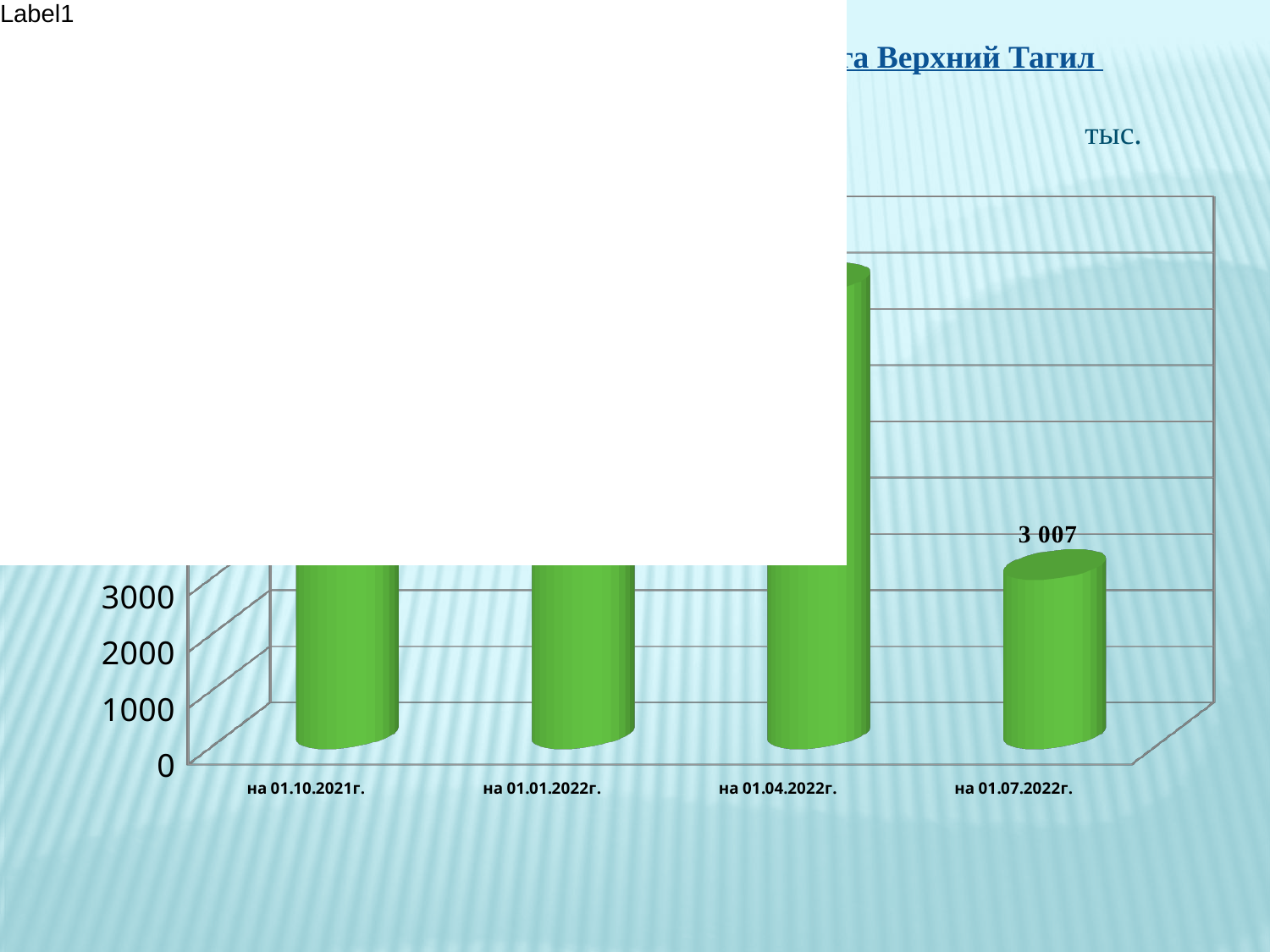
Which is larger, the value for на 01.04.2022г. or the value for на 01.07.2022г.? на 01.04.2022г. What is the label of the first category on the x axis? на 01.10.2021г. What kind of chart is shown on the slide? bar chart How many categories are shown on the x axis? 4 What is the value for на 01.07.2022г.? 3 007 What is the label of the last category on the x axis? на 01.07.2022г. Is the value for на 01.04.2022г. greater or less than 3000? greater Is the value for на 01.07.2022г. greater or less than 2000? greater